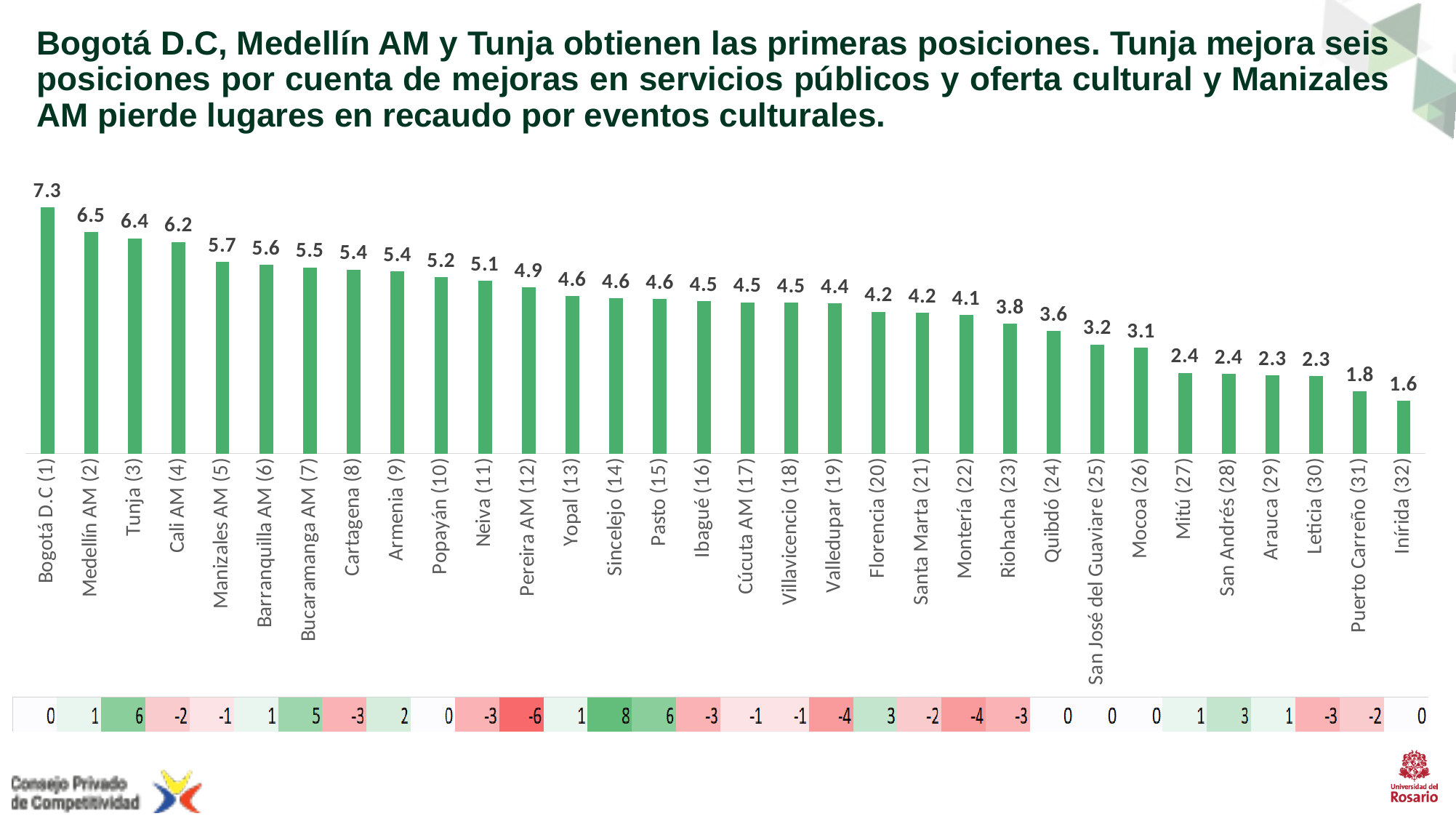
Do the values rise or fall from left to right along the x axis? Fall Which city has the highest value? Bogotá D.C (1) What is the value for Tunja (3)? 6.4 How many cities are shown in the bar chart? 32 What kind of chart is shown on the slide? Bar chart What is the value for Inírida (32)? 1.6 Which has a larger value, Cali AM (4) or Cartagena (8)? Cali AM (4) What colour are the bars in the chart? Green What is the value for Bogotá D.C (1)? 7.3 What is the value for Manizales AM (5)? 5.7 Which city has the lowest value? Inírida (32) What is the difference between the values for Bogotá D.C (1) and Medellín AM (2)? 0.8